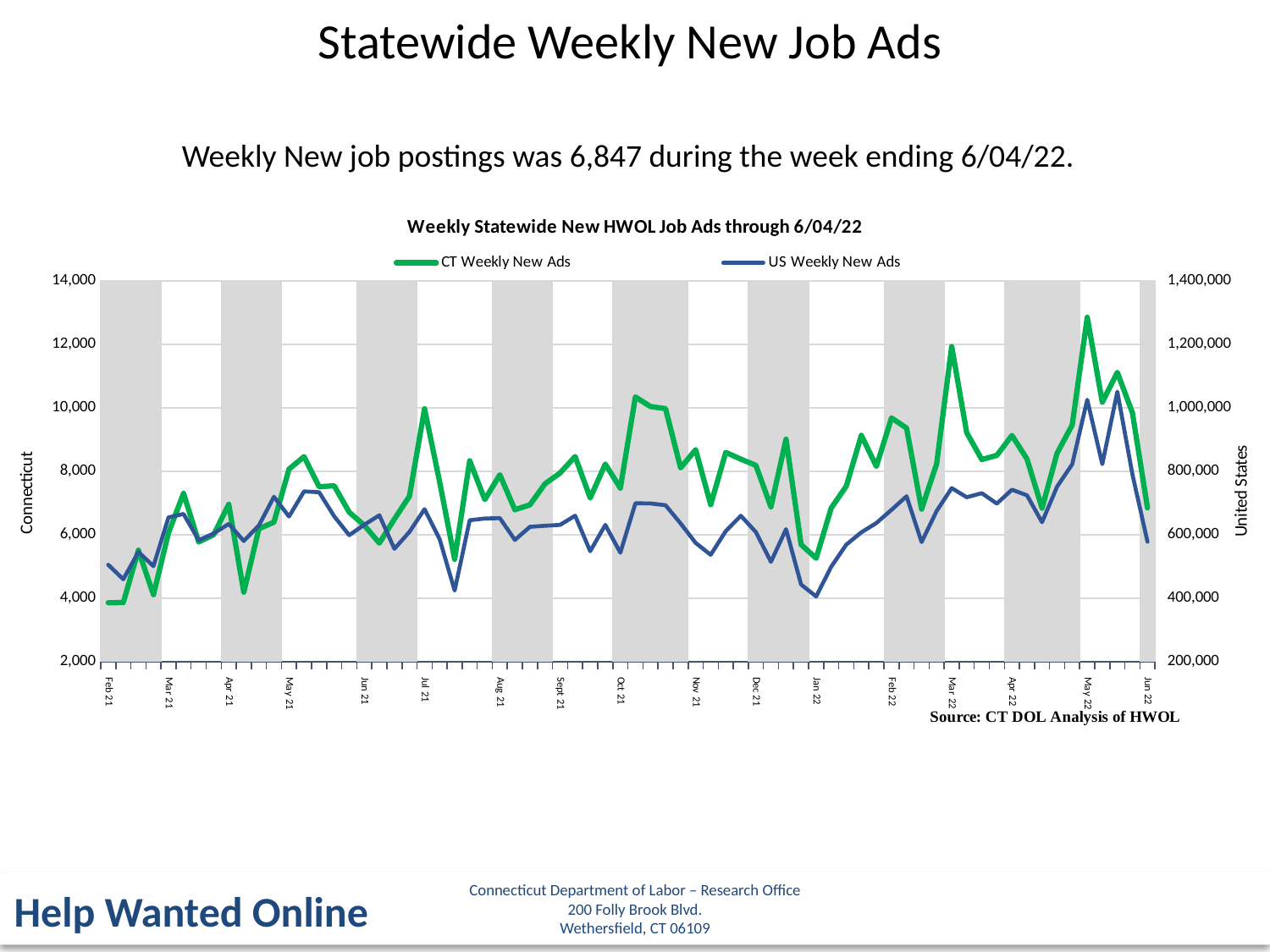
Is the first value of US Weekly New Ads at Feb 21 greater or less than 600,000? less What label is on the left vertical axis of the chart? Connecticut What is the title of the chart? Weekly Statewide New HWOL Job Ads through 6/04/22 Is the CT Weekly New Ads value at the Jan 22 low greater or less than 6,000? less How many series does the chart's legend list? 2 Is the lowest value of US Weekly New Ads around Jan 22 greater or less than 500,000? less Between Jan 22 and May 22, does the CT Weekly New Ads series generally rise or fall? rise According to the slide, what was the number of weekly new job postings during the week ending 6/04/22? 6,847 What kind of chart is shown on the slide? line chart Around which month does the CT Weekly New Ads series reach its highest point? May 22